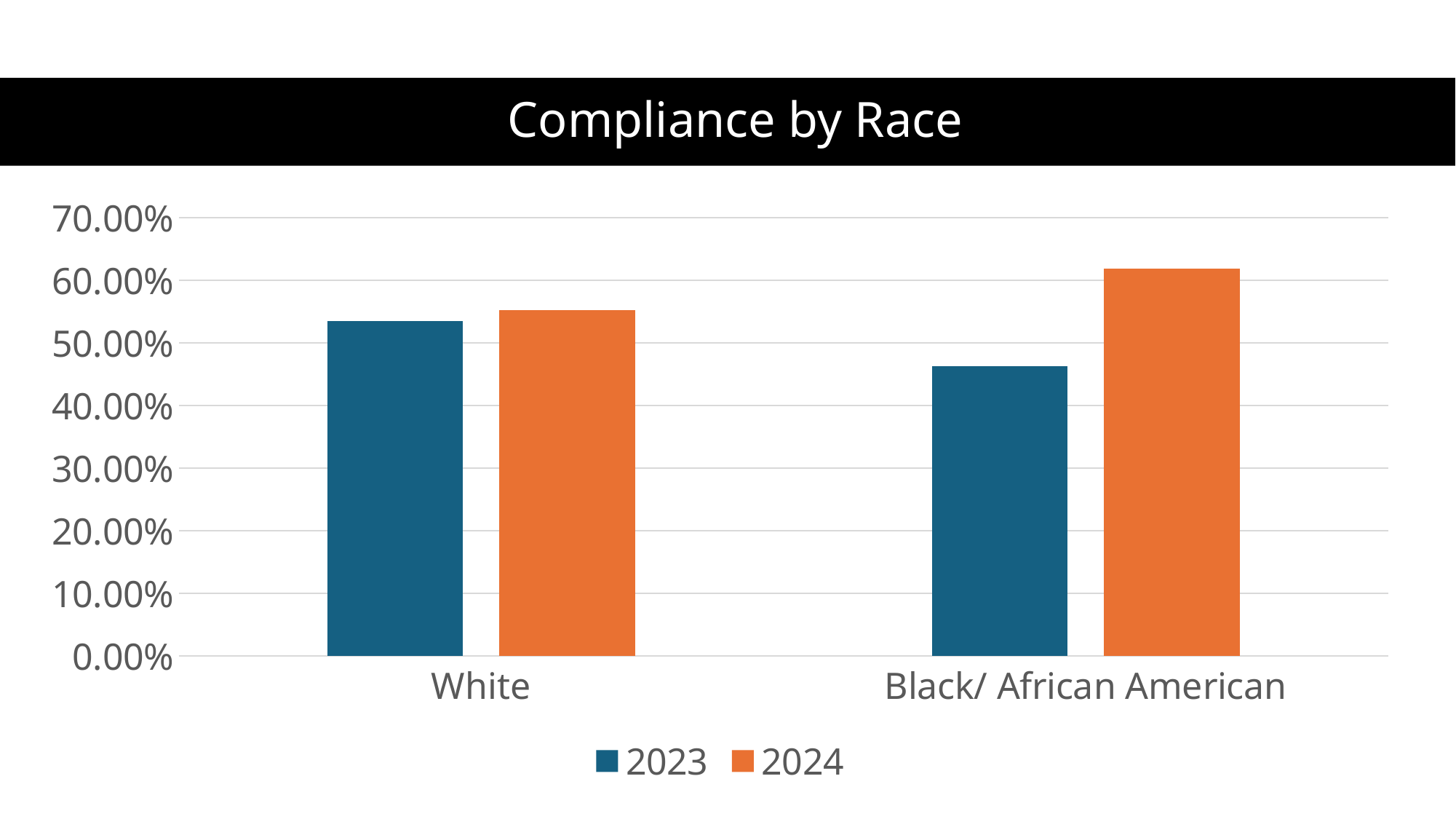
What type of chart is shown on the slide? bar chart Which colour represents the 2024 series in the legend? orange Which category and year has the lowest compliance value? Black/ African American, 2023 Is the 2023 value for White greater or less than 50.00%? greater Which category and year has the highest compliance value? Black/ African American, 2024 How many series does the legend list? 2 Is the 2023 value for Black/ African American greater or less than 50.00%? less What is the title of the chart? Compliance by Race How many race categories are shown on the x axis? 2 Is the 2024 value for White greater or less than 60.00%? less For Black/ African American, which year has the larger value, 2023 or 2024? 2024